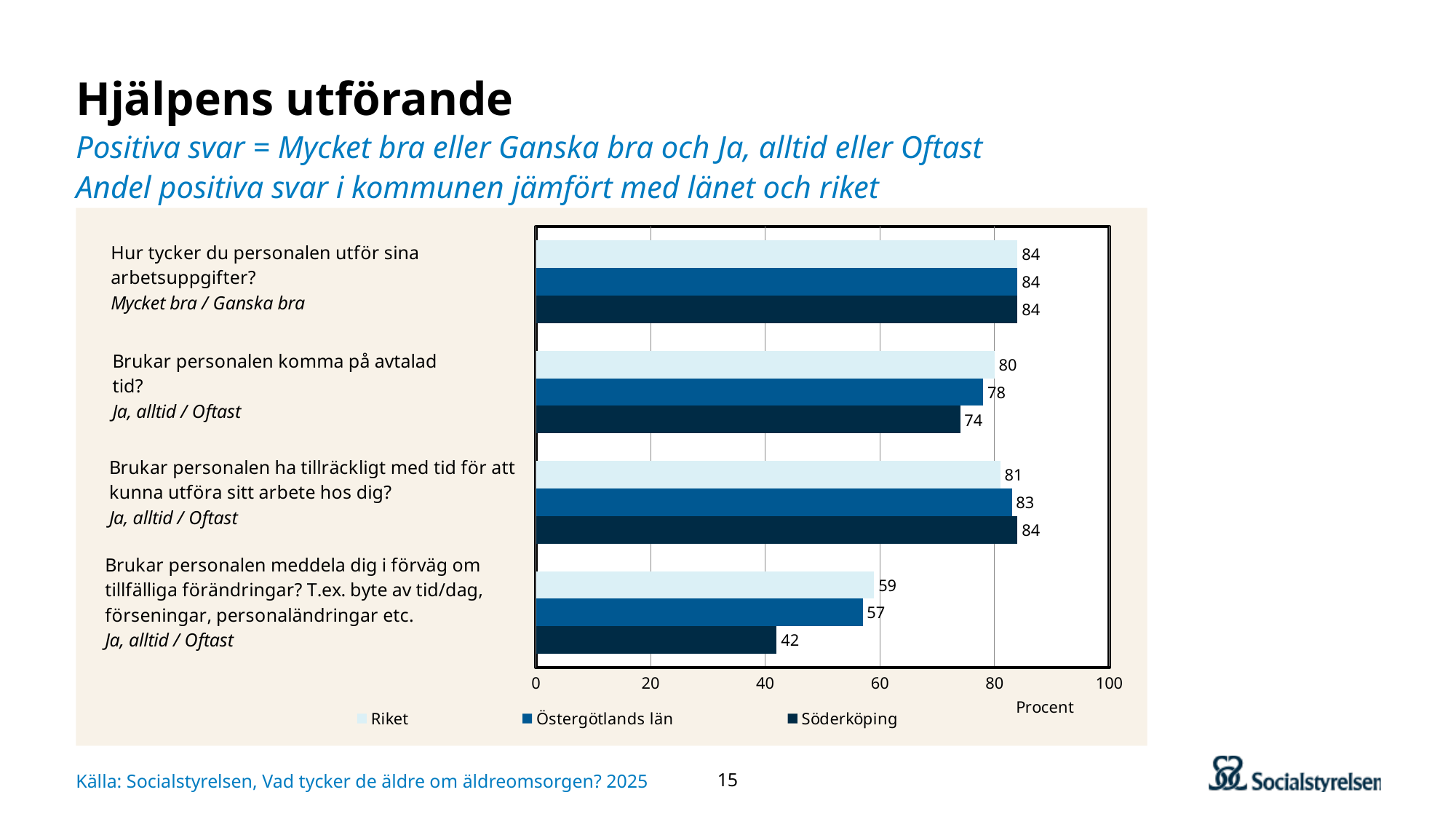
Is the value for Söderköping for "Brukar personalen meddela dig i förväg om tillfälliga förändringar?" greater or less than 60? less What is the value for Söderköping for "Brukar personalen komma på avtalad tid?" 74 What is the value for Riket for "Brukar personalen meddela dig i förväg om tillfälliga förändringar?" 59 For which survey question does Söderköping have its lowest value? Brukar personalen meddela dig i förväg om tillfälliga förändringar? What unit label is shown on the x axis of the chart? Procent How many series does the legend list? 3 What is the value for Östergötlands län for "Brukar personalen ha tillräckligt med tid för att kunna utföra sitt arbete hos dig?" 83 What type of chart is shown on the slide? bar chart How many survey questions (categories) are plotted in the chart? 4 What is the difference between Söderköping and Riket for "Brukar personalen ha tillräckligt med tid för att kunna utföra sitt arbete hos dig?" 3 For "Brukar personalen komma på avtalad tid?", which is larger: Riket or Söderköping? Riket What is the difference between Riket and Söderköping for "Brukar personalen meddela dig i förväg om tillfälliga förändringar?" 17